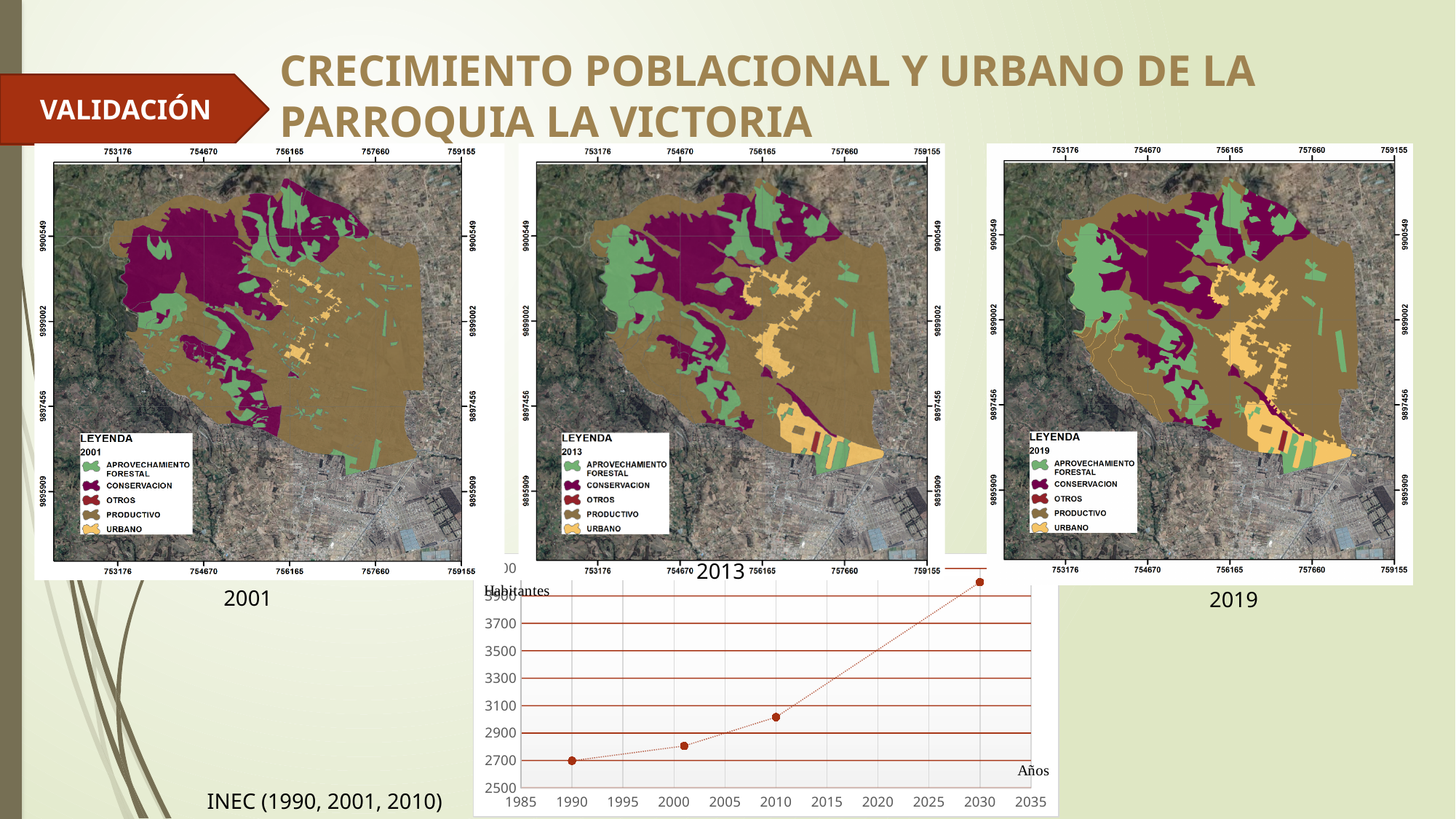
In the bottom chart, do the values rise or fall as the years increase along the x axis? rise In the bottom chart, is the value for 1990 greater or less than 2900? less In the bottom chart, is the value for 2001 greater or less than 2900? less In the bottom chart, is the value for 2010 greater or less than 2900? greater What is the label of the y axis of the bottom chart? Habitantes In the bottom chart, which has the larger value, 2001 or 2010? 2010 In the bottom chart, how many data points are plotted? 4 In the bottom chart, which year has the lowest number of Habitantes? 1990 What kind of chart is shown at the bottom of the slide? line chart In the bottom chart, which year has the highest number of Habitantes? 2030 What is the label of the x axis of the bottom chart? Años